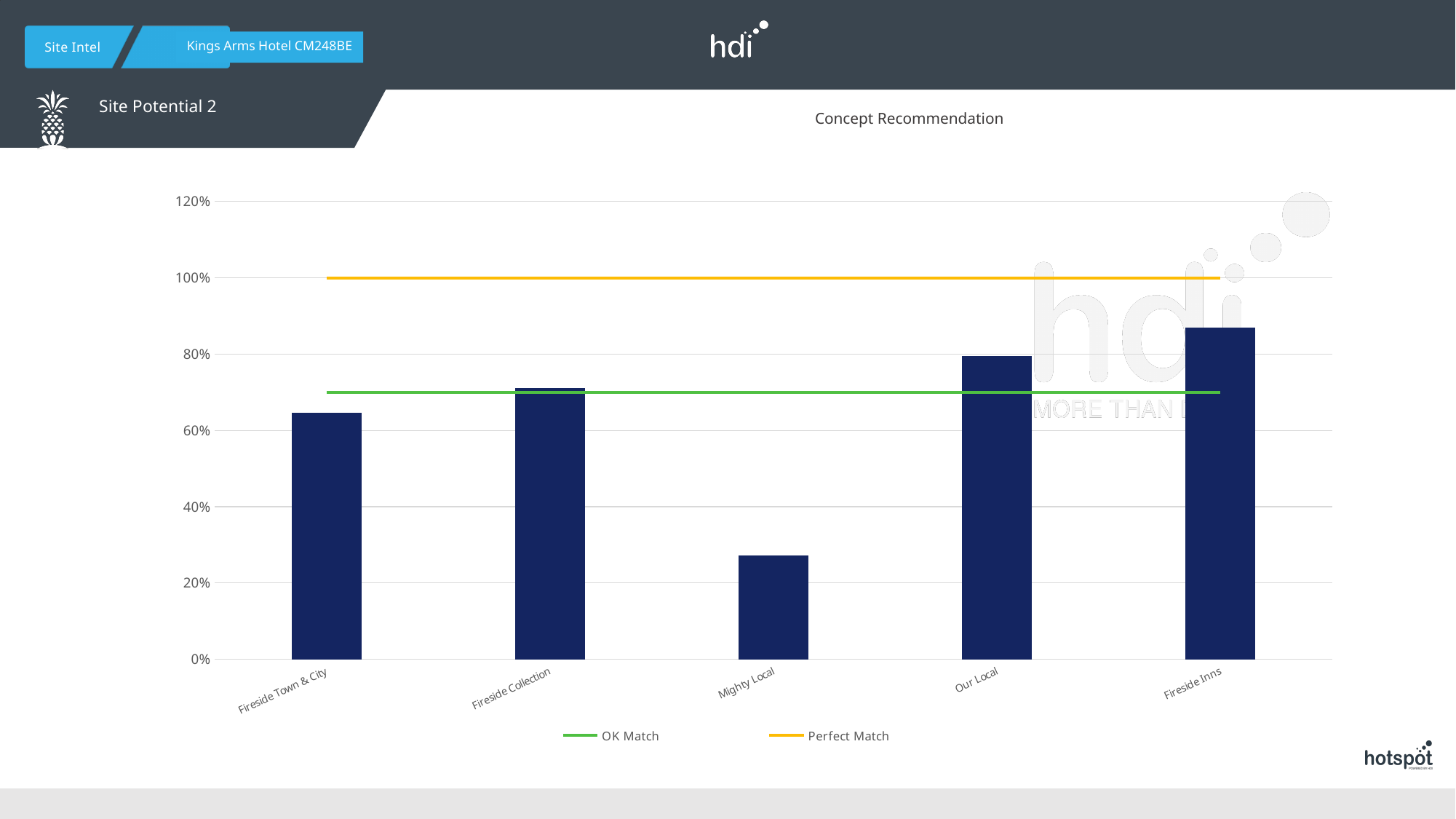
Which concept has the highest bar? Fireside Inns Is the value for Fireside Town & City greater or less than 60%? greater Is the value for Fireside Inns greater or less than 80%? greater Which concept has the lowest bar? Mighty Local How many concepts (categories) are plotted on the x axis? 5 How many entries does the legend list? 2 What kind of chart is shown on the slide? Bar chart Which is larger, the value for Our Local or the value for Fireside Collection? Our Local Which legend entry is shown with a yellow line? Perfect Match Is the value for Mighty Local greater or less than 40%? less What is the title of the chart? Concept Recommendation